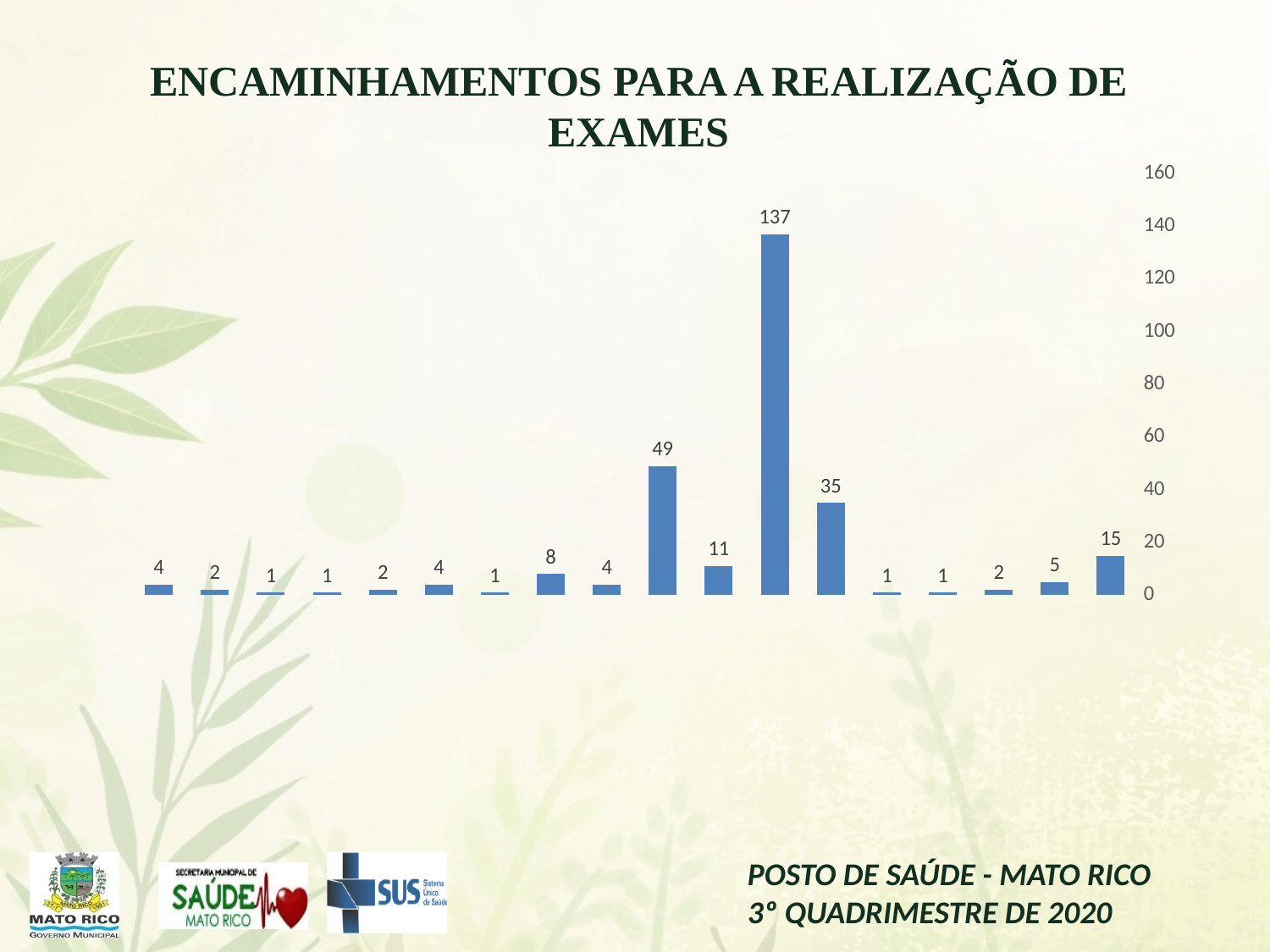
What is the value of the tallest bar in the chart? 137 Is the value of the tallest bar greater or less than 120? greater How many bars in the chart have a value of 1? 5 What is the value of the first bar on the left of the chart? 4 What kind of chart is shown on the slide? bar chart What is the difference between the bars labelled 49 and 35? 14 What is the smallest value shown on any bar in the chart? 1 How many bars are plotted in the chart? 18 What is the highest value shown on the vertical axis of the chart? 160 What is the title of the chart on the slide? ENCAMINHAMENTOS PARA A REALIZAÇÃO DE EXAMES What is the difference between the tallest bar (137) and the second tallest bar (49)? 88 What is the value of the last bar on the right of the chart? 15